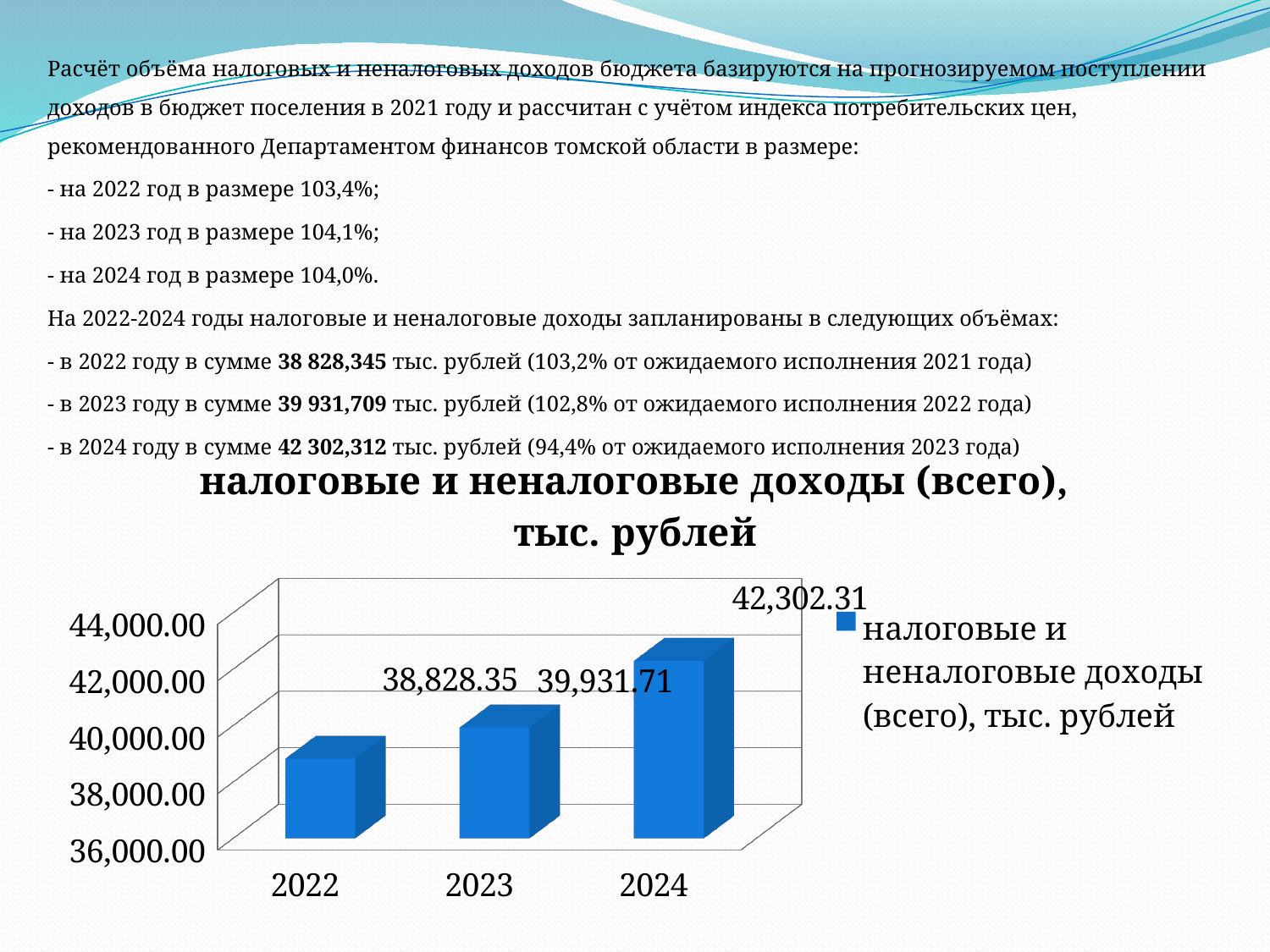
Is the value for 2024 greater or less than 42,000.00? greater How many years are shown on the x axis of the chart? 3 Which year has the lowest value in the chart? 2022 Which year has the highest value in the chart? 2024 Which is larger, the value for 2023 or the value for 2024? 2024 What is the value for 2022 in the chart? 38,828.35 What is the value for 2024 in the chart? 42,302.31 What is the difference between the values for 2023 and 2022? 1,103.36 What is the difference between the values for 2024 and 2022? 3,473.96 What kind of chart is shown on the slide? bar chart Do the values rise or fall from 2022 to 2024? rise What is the value for 2023 in the chart? 39,931.71